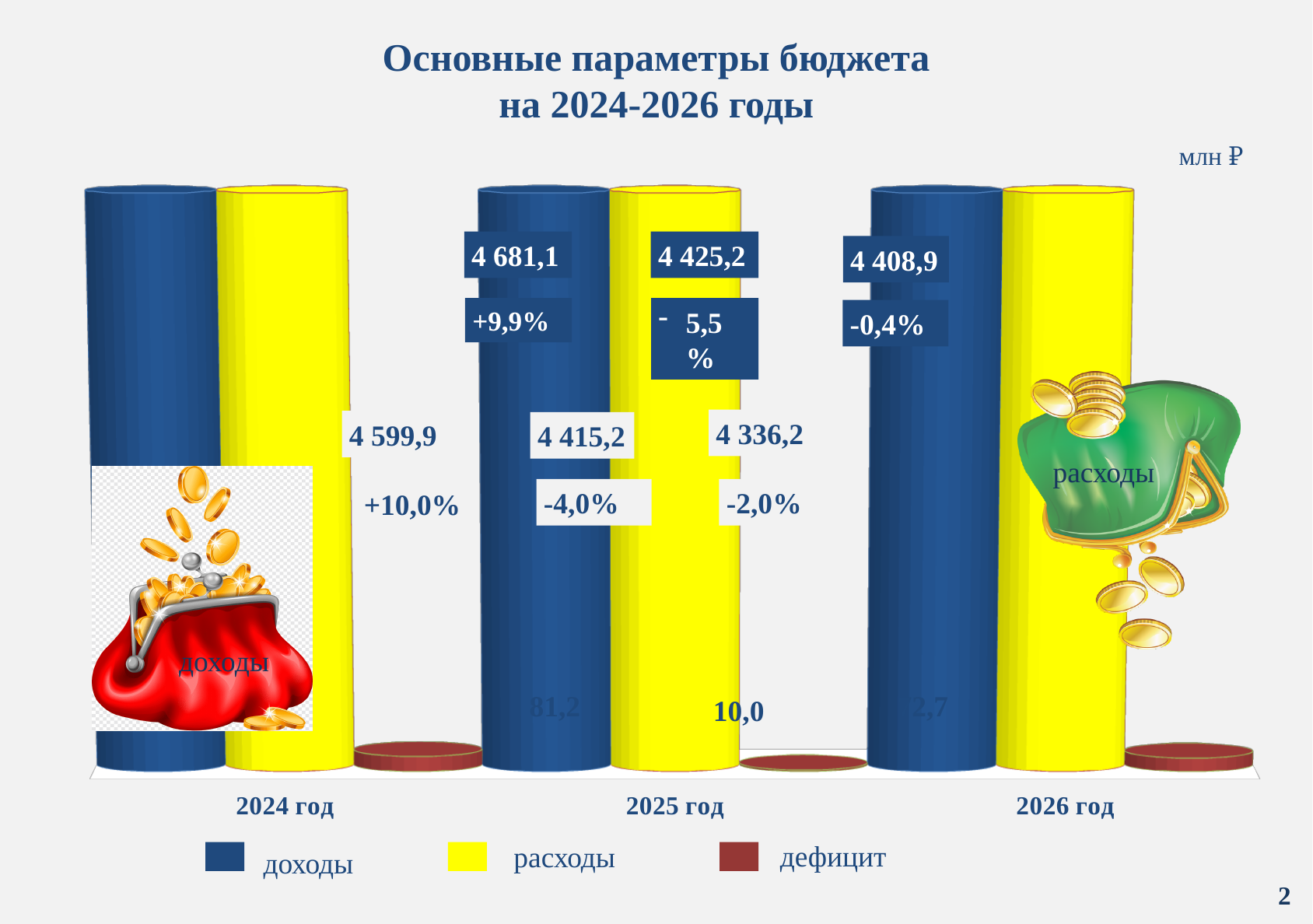
What percentage change is printed next to the value 4 599,9? +10,0% What kind of chart is shown on the slide? bar chart Which series has the smallest bars in every year? дефицит Which value is printed together with the change -0,4%? 4 408,9 Which value is printed together with the change -4,0%? 4 415,2 Which series is shown in yellow according to the legend? расходы Which value is printed together with the change -2,0%? 4 336,2 What is the title of the chart? Основные параметры бюджета на 2024-2026 годы What percentage change is printed next to the value 4 681,1? +9,9% What unit is indicated for the chart values? млн ₽ How many series does the legend list? 3 How many year categories are shown on the x axis? 3